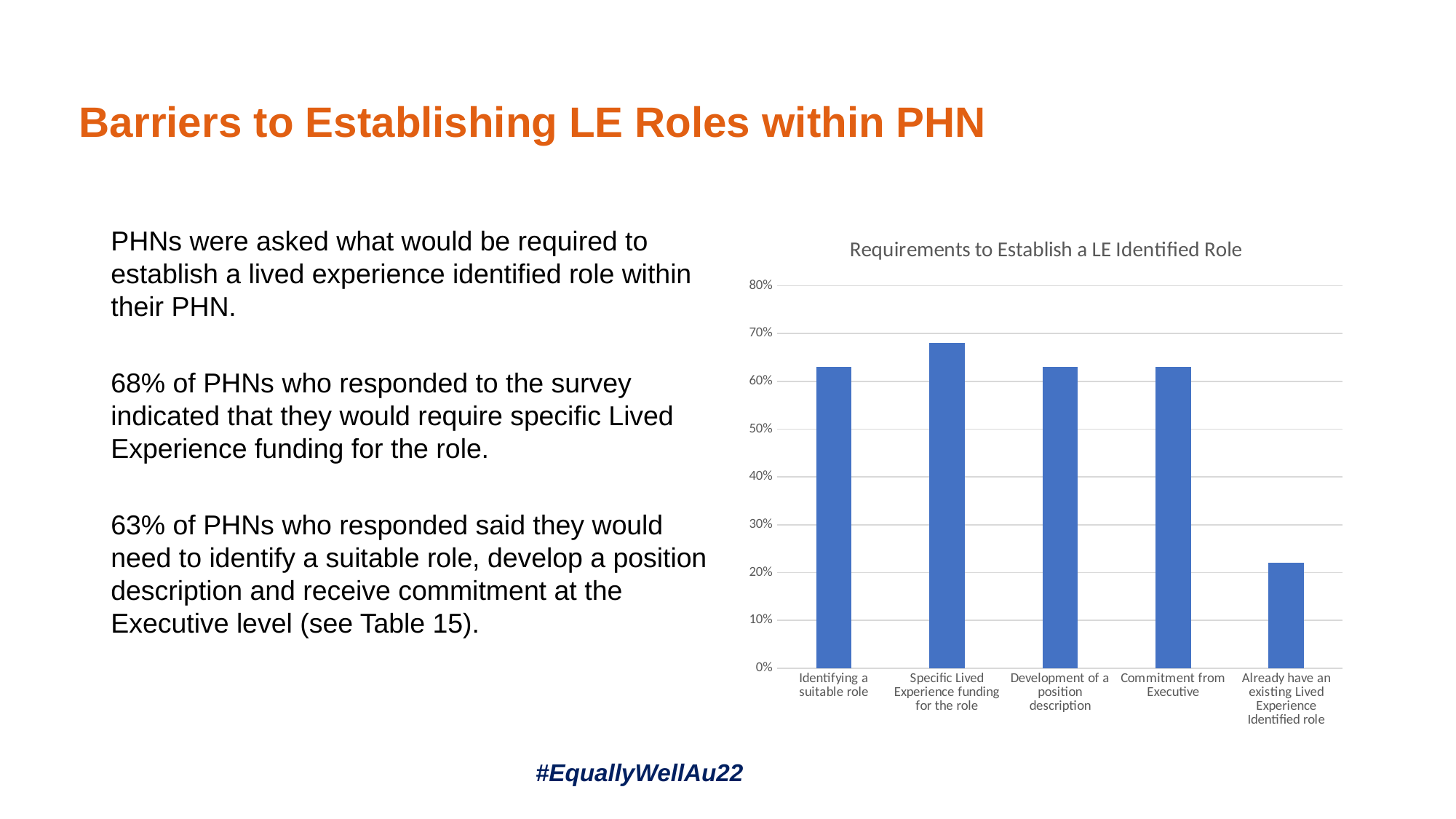
What is the difference in percentage points between 'Specific Lived Experience funding for the role' and 'Development of a position description'? 5 percentage points What percentage of PHNs said they would need to identify a suitable role? 63% Which category has the highest value in the chart? Specific Lived Experience funding for the role What type of chart is shown on the slide? bar chart What percentage of PHNs indicated they would require specific Lived Experience funding for the role? 68% How many categories are shown on the x axis of the chart? 5 Which category has the lowest value in the chart? Already have an existing Lived Experience Identified role Is the value for 'Commitment from Executive' greater or less than 50%? greater Is the value for 'Already have an existing Lived Experience Identified role' greater or less than 30%? less Which is larger: the value for 'Specific Lived Experience funding for the role' or 'Commitment from Executive'? Specific Lived Experience funding for the role What is the title of the chart? Requirements to Establish a LE Identified Role Is the value for 'Already have an existing Lived Experience Identified role' greater or less than 20%? greater